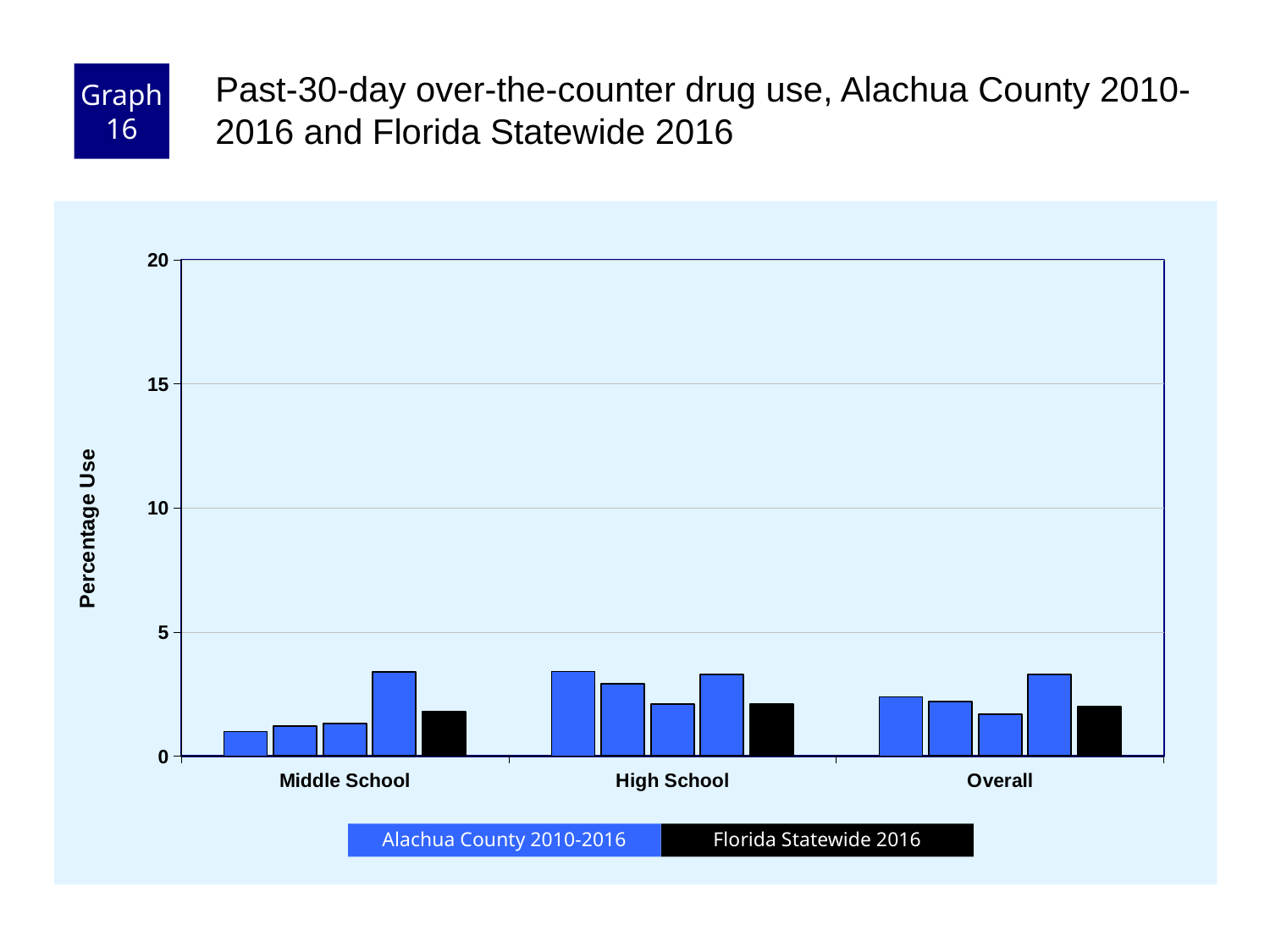
Is the value for Florida Statewide 2016 in the Overall group greater or less than 10? less Which colour represents Florida Statewide 2016 in the legend? black Is the value for Florida Statewide 2016 in the Middle School group greater or less than 5? less How many series does the legend list? 2 Are any of the Alachua County 2010-2016 bars greater than 5? no Which is larger: the leftmost Alachua County 2010-2016 bar in the Middle School group or the leftmost Alachua County 2010-2016 bar in the High School group? the leftmost Alachua County 2010-2016 bar in the High School group In the Middle School group, which is larger: the Florida Statewide 2016 bar or the tallest Alachua County 2010-2016 bar? the tallest Alachua County 2010-2016 bar How many categories are shown on the x axis? 3 What kind of chart is shown on the slide? bar chart What is the highest value shown on the y axis? 20 What is the label on the y axis? Percentage Use